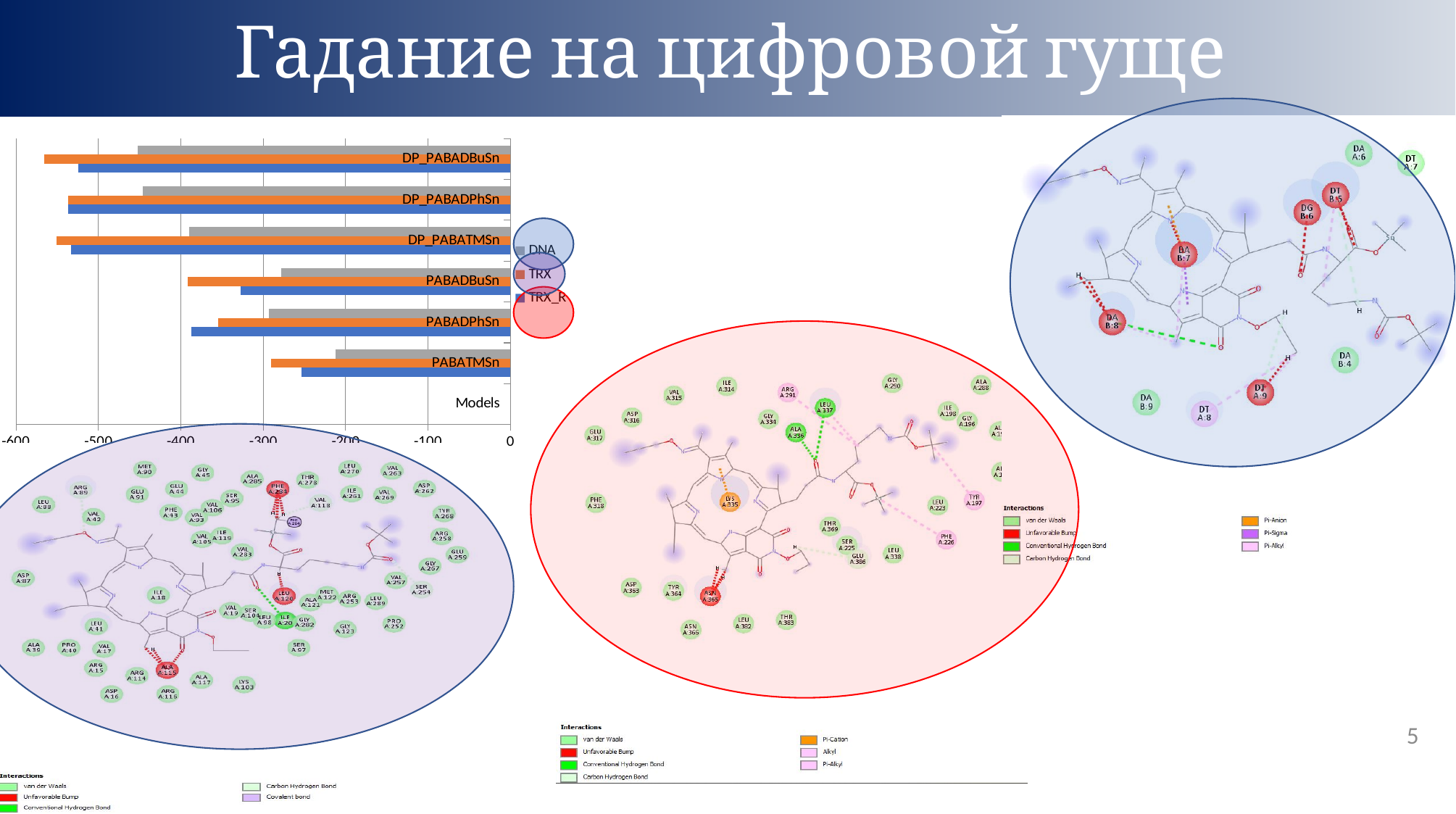
In the bar chart, which category has the shortest TRX_R bar? PABATMSn In the bar chart, is the DNA value for PABATMSn greater or less than -300? greater How many categories (models) are plotted in the bar chart? 6 In the bar chart, for DP_PABATMSn, which series has the longer bar: DNA or TRX_R? TRX_R How many series does the legend of the bar chart list? 3 What kind of chart is shown on the left of the slide? bar chart What is the axis label shown at the bottom right of the bar chart's plot area? Models In the bar chart, which category has the shortest TRX bar? PABATMSn In the bar chart, is the TRX value for DP_PABADBuSn greater or less than -500? less In the bar chart, which category has the shortest DNA bar? PABATMSn What are the three series named in the legend of the bar chart? DNA, TRX, TRX_R In the bar chart, for PABATMSn, which series has the longer bar: DNA or TRX? TRX